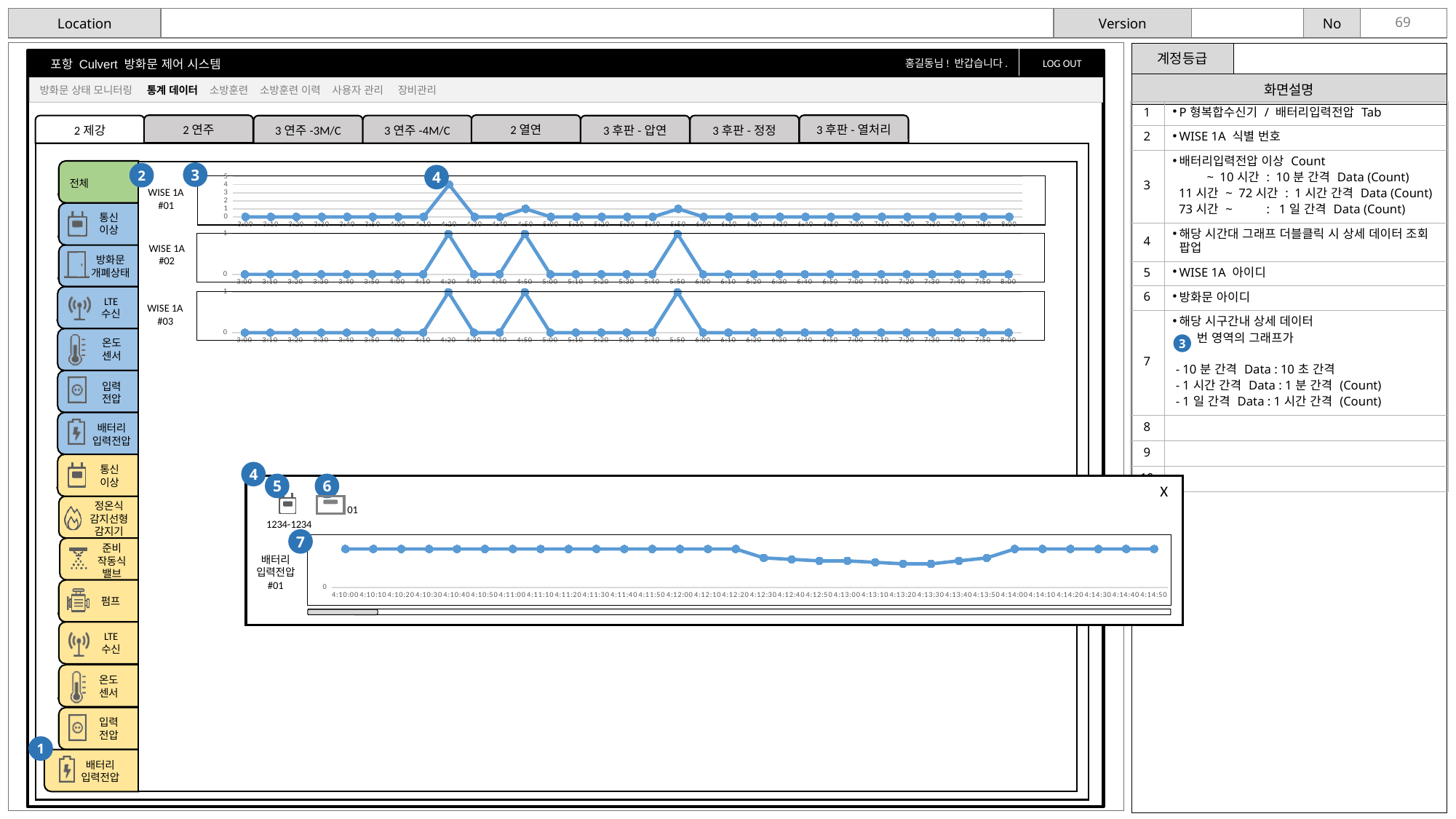
On the 배터리 입력전압 #01 chart in the popup, does the line dip or rise in the middle section around 4:12:30 to 4:13:40 compared with the start? dip On the WISE 1A #03 chart, what is the value at 5:50? 1 What kind of chart is the WISE 1A #02 chart? line chart On the WISE 1A #02 chart, what is the value at 4:20? 1 On the WISE 1A #01 chart, at which time is the highest point? 4:20 On the WISE 1A #01 chart, which is larger, the value at 4:20 or the value at 4:50? 4:20 How many line charts are shown on the slide in total? 4 On the WISE 1A #03 chart, how many times does the line rise to 1? 3 On the WISE 1A #02 chart, what is the value at 3:00? 0 What is the first time label on the x axis of the 배터리 입력전압 #01 chart in the popup? 4:10:00 On the WISE 1A #01 chart, is the value at 4:20 greater or less than 3? greater What is the last time label on the x axis of the WISE 1A #02 chart? 8:00